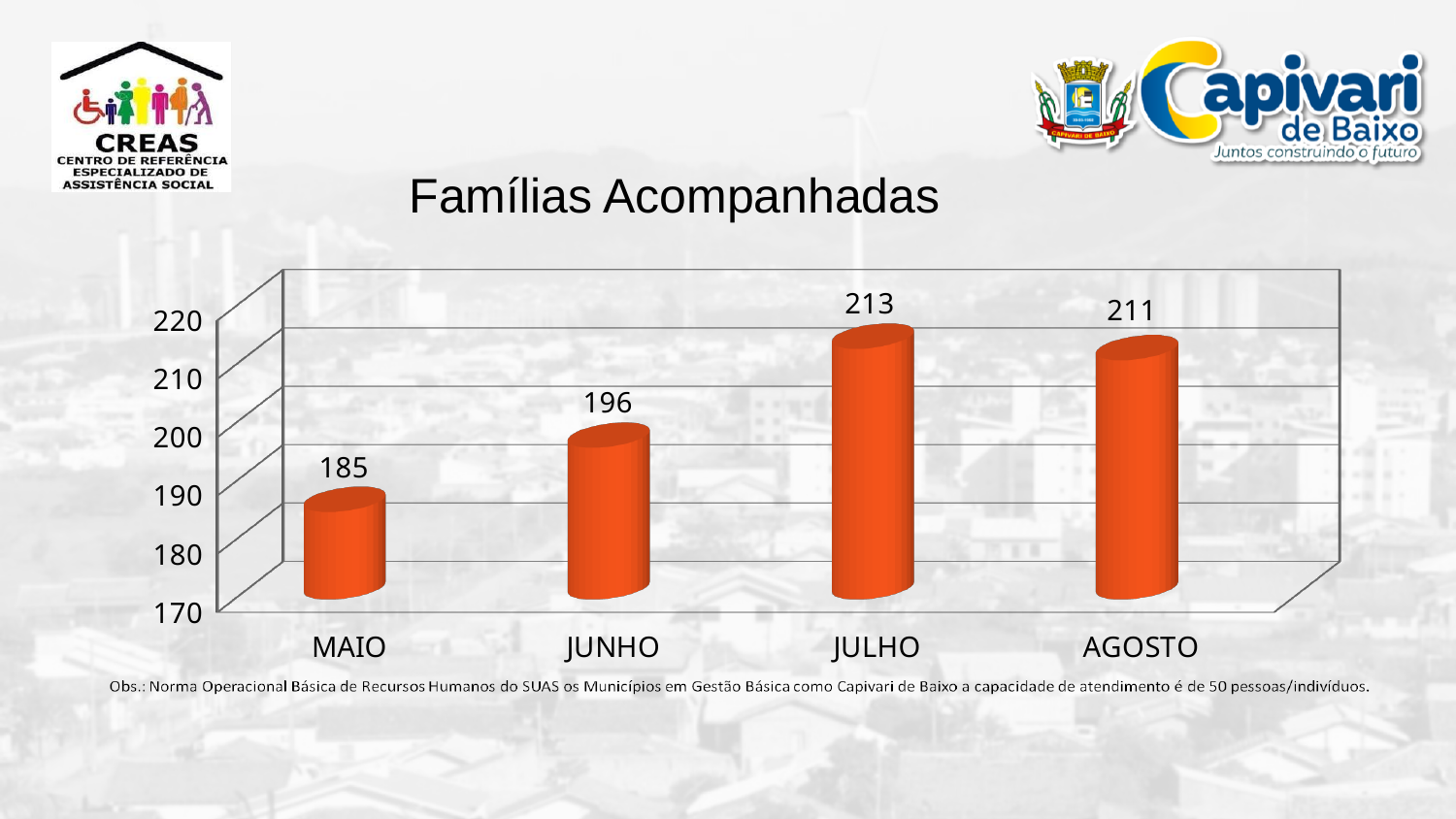
What is the value for JULHO? 213 Which is larger, the value for JUNHO or the value for AGOSTO? AGOSTO What is the title of the chart? Famílias Acompanhadas How many months are shown on the chart? 4 What is the value for MAIO? 185 Which month has the lowest value? MAIO What kind of chart is shown on the slide? bar chart What is the difference between the values for JUNHO and MAIO? 11 What is the value for AGOSTO? 211 Is the value for JUNHO greater or less than 200? less Which month has the highest value? JULHO What is the difference between the values for JULHO and AGOSTO? 2